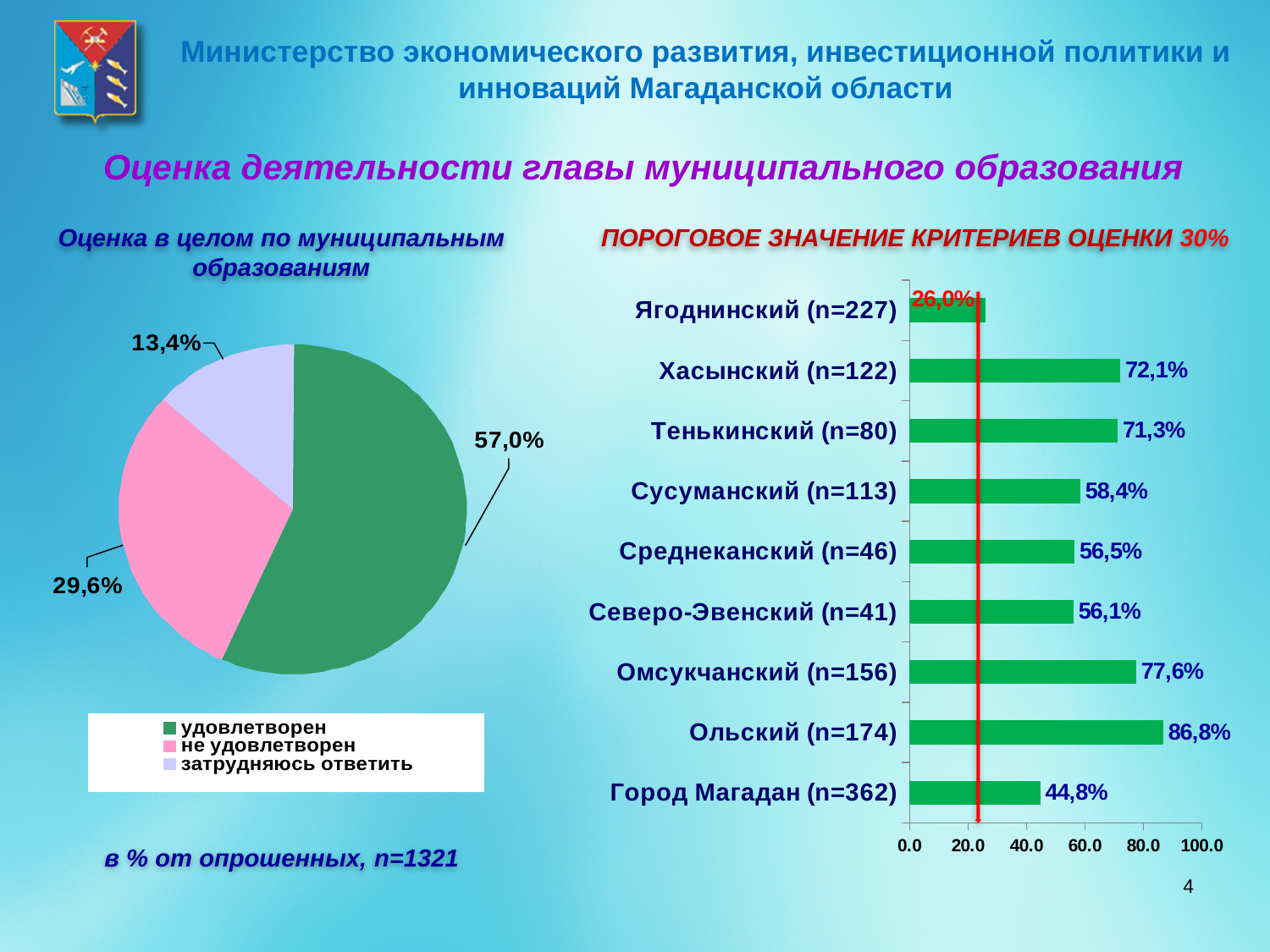
In the bar chart on the right, which municipality has the lowest value? Ягоднинский (n=227) In the pie chart on the left, which response has the smallest slice? затрудняюсь ответить What type of chart is shown on the right side of the slide? bar chart In the bar chart on the right, what is the value for Город Магадан (n=362)? 44,8% In the bar chart on the right, what is the difference between the values for Омсукчанский (n=156) and Сусуманский (n=113)? 19,2% In the bar chart on the right, how many municipalities are shown? 9 In the pie chart on the left, how many entries does the legend list? 3 In the bar chart on the right, which municipality has the highest value? Ольский (n=174) In the pie chart on the left, what share of respondents answered "удовлетворен"? 57,0% In the bar chart on the right, which is larger: the value for Хасынский (n=122) or Город Магадан (n=362)? Хасынский (n=122) In the bar chart on the right, what is the value for Ольский (n=174)? 86,8% In the pie chart on the left, what share of respondents answered "затрудняюсь ответить"? 13,4%